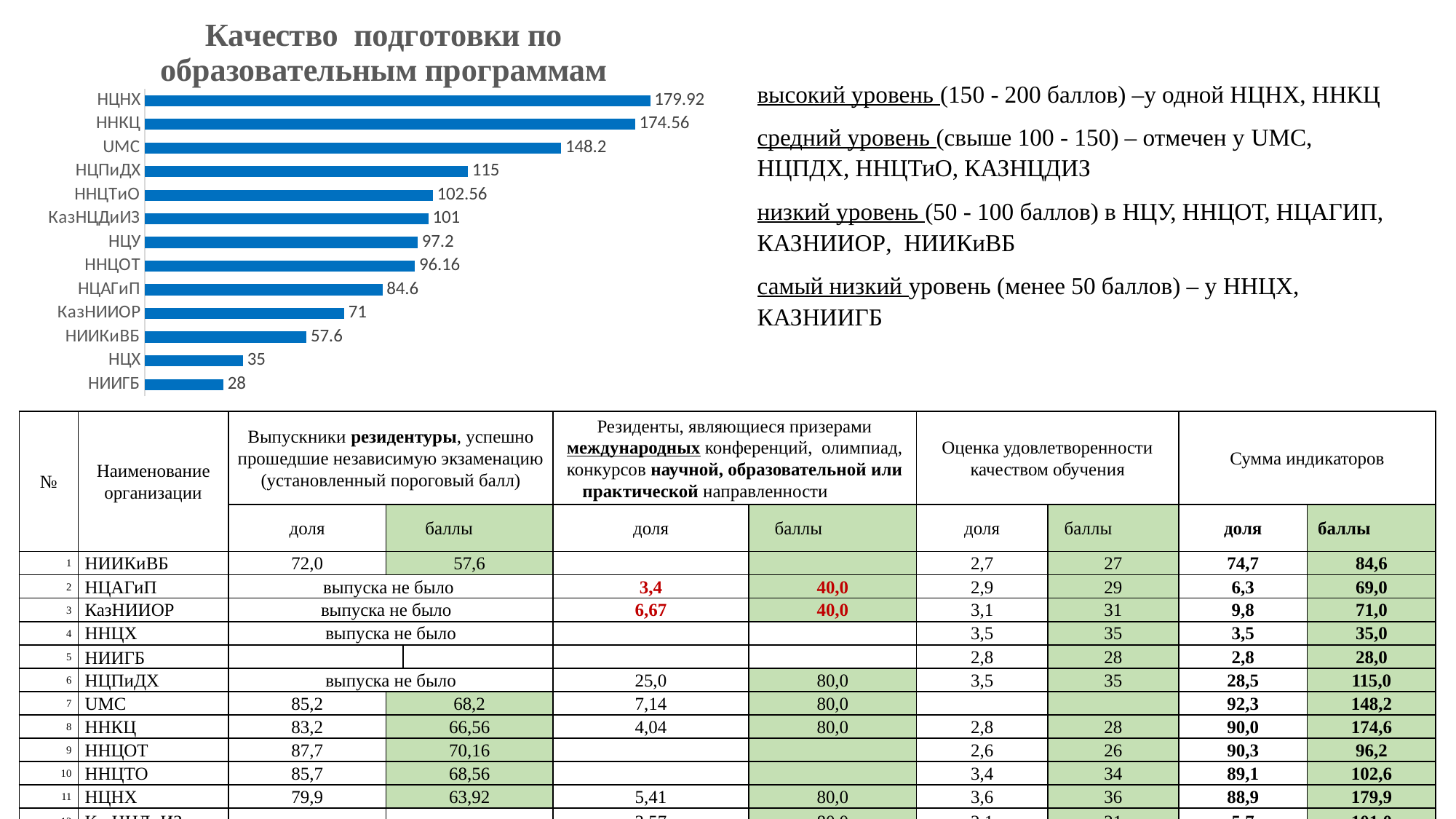
What is the value for НЦНХ in the bar chart? 179.92 What type of chart is shown on the slide? Bar chart How many categories are shown in the bar chart? 13 Which category has the lowest value in the bar chart? НИИГБ What is the difference between the values for НЦНХ and ННКЦ in the bar chart? 5.36 What is the value for UMC in the bar chart? 148.2 Which category has the highest value in the bar chart? НЦНХ Which has a larger value in the bar chart, НЦПиДХ or ННЦТиО? НЦПиДХ What is the title of the chart? Качество подготовки по образовательным программам What is the value for КазНЦДиИЗ in the bar chart? 101 What is the value for НИИКиВБ in the bar chart? 57.6 What is the difference between the values for НЦХ and НИИГБ in the bar chart? 7